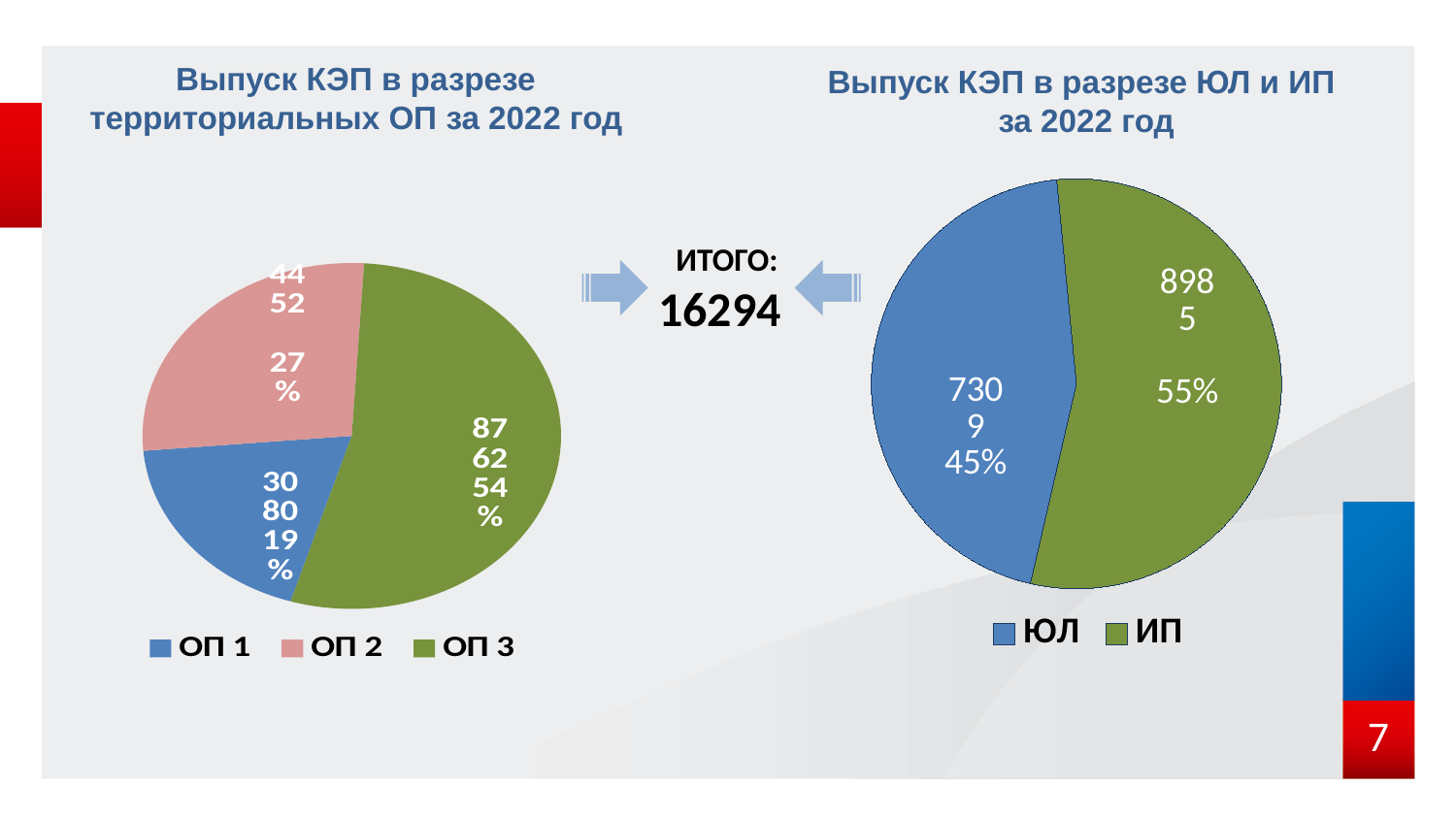
In the right chart, 'Выпуск КЭП в разрезе ЮЛ и ИП за 2022 год', what share does ИП have? 55% In the right chart, 'Выпуск КЭП в разрезе ЮЛ и ИП за 2022 год', which category has the larger slice? ИП How many categories does the legend of the right chart, 'Выпуск КЭП в разрезе ЮЛ и ИП за 2022 год', list? 2 In the left chart, 'Выпуск КЭП в разрезе территориальных ОП за 2022 год', which category has the smallest slice? ОП 1 In the left chart, 'Выпуск КЭП в разрезе территориальных ОП за 2022 год', which is larger: ОП 2 or ОП 1? ОП 2 What type of chart is used on the left chart, 'Выпуск КЭП в разрезе территориальных ОП за 2022 год'? Pie chart How many categories does the legend of the left chart, 'Выпуск КЭП в разрезе территориальных ОП за 2022 год', list? 3 What total (ИТОГО) is shown between the two charts? 16294 In the left chart, 'Выпуск КЭП в разрезе территориальных ОП за 2022 год', what share does ОП 1 have? 19% In the left chart, 'Выпуск КЭП в разрезе территориальных ОП за 2022 год', what share does ОП 3 have? 54% In the left chart, 'Выпуск КЭП в разрезе территориальных ОП за 2022 год', which category has the largest slice? ОП 3